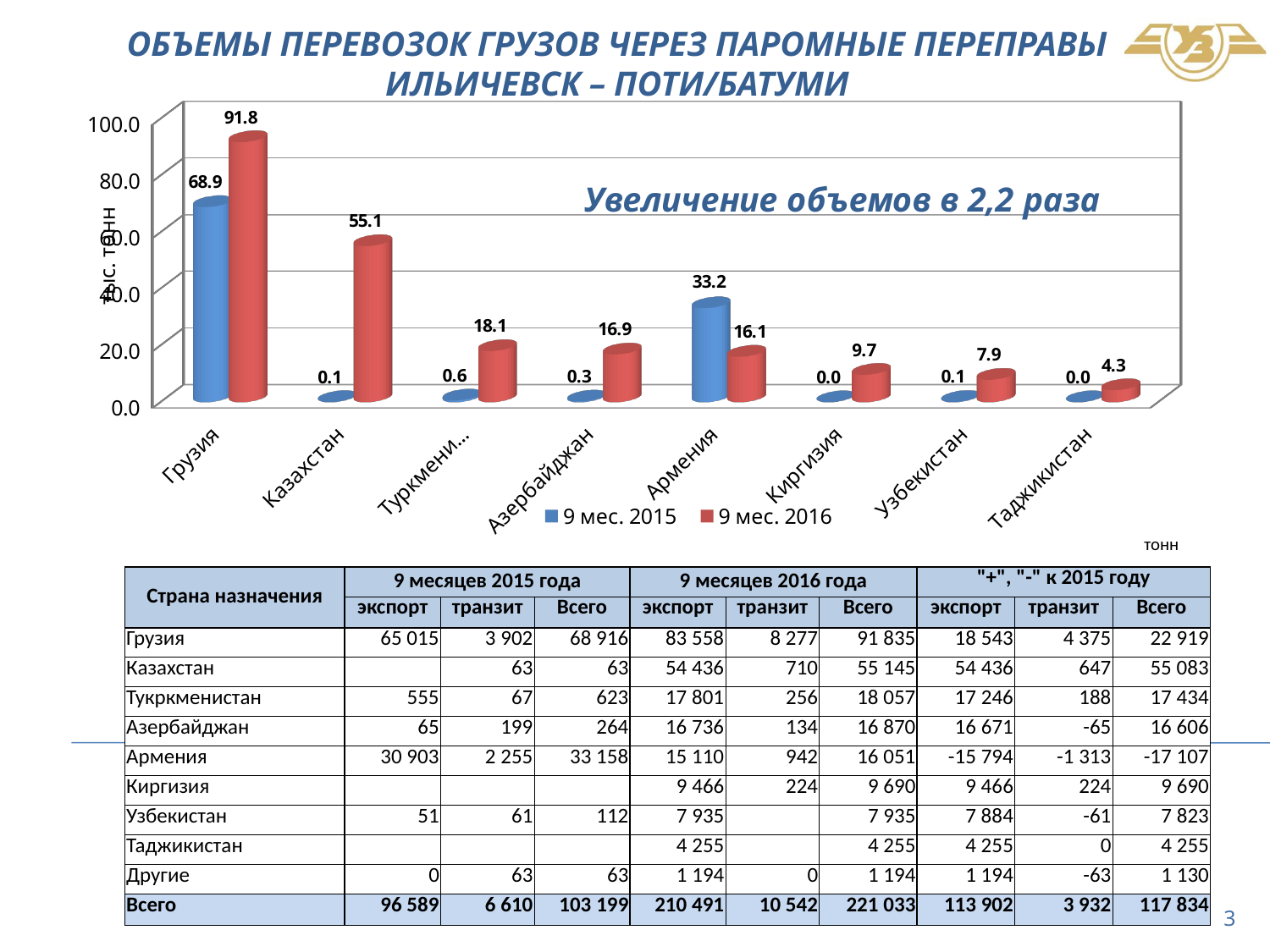
What is the difference between the 9 мес. 2016 and 9 мес. 2015 values for Грузия? 22.9 What is the value for Казахстан in the 9 мес. 2016 series? 55.1 What is the value for Армения in the 9 мес. 2015 series? 33.2 How many categories are shown on the x axis of the chart? 8 For Армения, which series has the larger value: 9 мес. 2015 or 9 мес. 2016? 9 мес. 2015 What type of chart is shown on the slide? bar chart Which category has the lowest value in the 9 мес. 2016 series? Таджикистан Which category has the highest value in the 9 мес. 2016 series? Грузия What is the value for Грузия in the 9 мес. 2016 series? 91.8 What is the value for Киргизия in the 9 мес. 2016 series? 9.7 How many series does the chart legend list? 2 Is the 9 мес. 2016 value for Азербайджан greater or less than 20.0? less